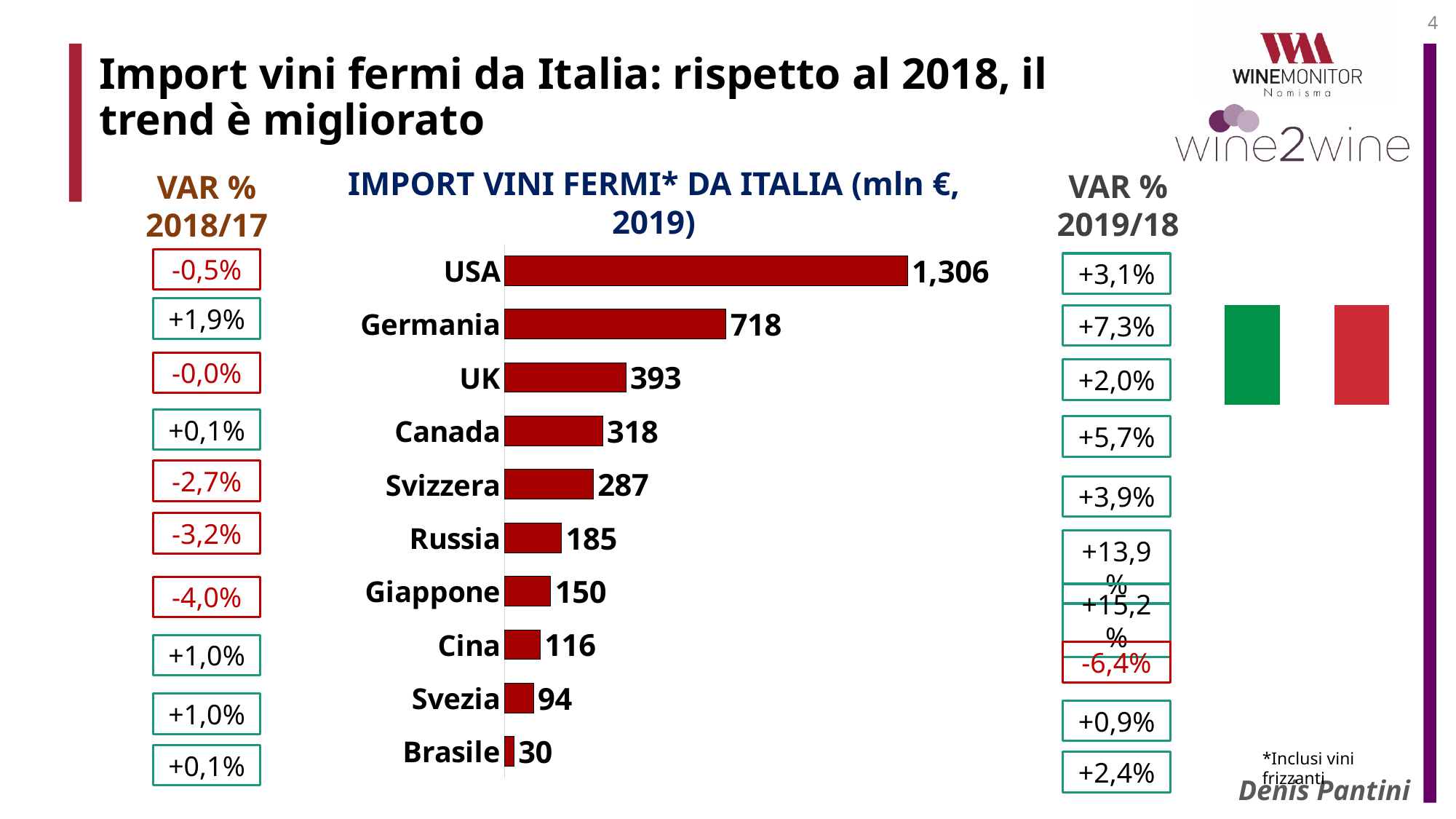
Do the import values rise or fall going from USA down to Brasile? fall Which country has the lowest import value? Brasile What is the import value for Svezia? 94 What kind of chart is shown on the slide? bar chart Which has a larger import value, Svizzera or Russia? Svizzera What is the difference between the import values for UK and Canada? 75 How many countries are shown in the chart? 10 What is the import value for Germania? 718 Which country has the highest import value? USA What is the title of the chart? IMPORT VINI FERMI* DA ITALIA (mln €, 2019) What is the import value for Canada? 318 What is the difference between the import values for USA and Germania? 588